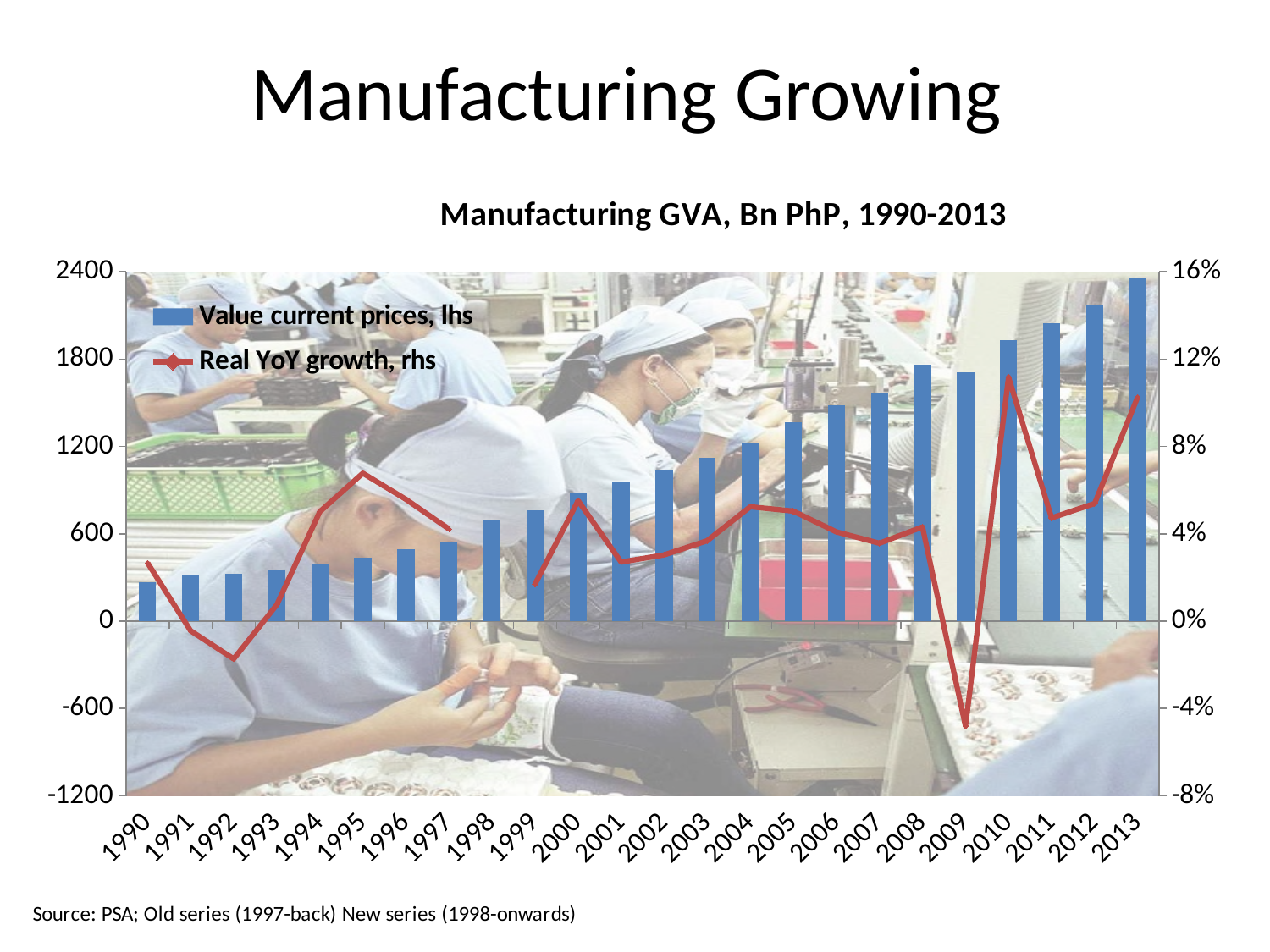
How many series does the legend list? 2 Is the Real YoY growth for 2009 greater or less than 0%? less Which year has the highest bar for Value current prices? 2013 What kind of chart is shown on the slide? A combined bar and line chart Which year has the lowest bar for Value current prices? 1990 How many years are shown on the x axis? 24 Which year has the lowest Real YoY growth? 2009 What is the title of the chart? Manufacturing GVA, Bn PhP, 1990-2013 Is the Real YoY growth for 2010 greater or less than 8%? greater Do the Value current prices bars generally rise or fall from 1990 to 2013? rise Is the Value current prices bar for 2013 greater or less than 1800? greater Which year has the larger Real YoY growth, 2009 or 2010? 2010